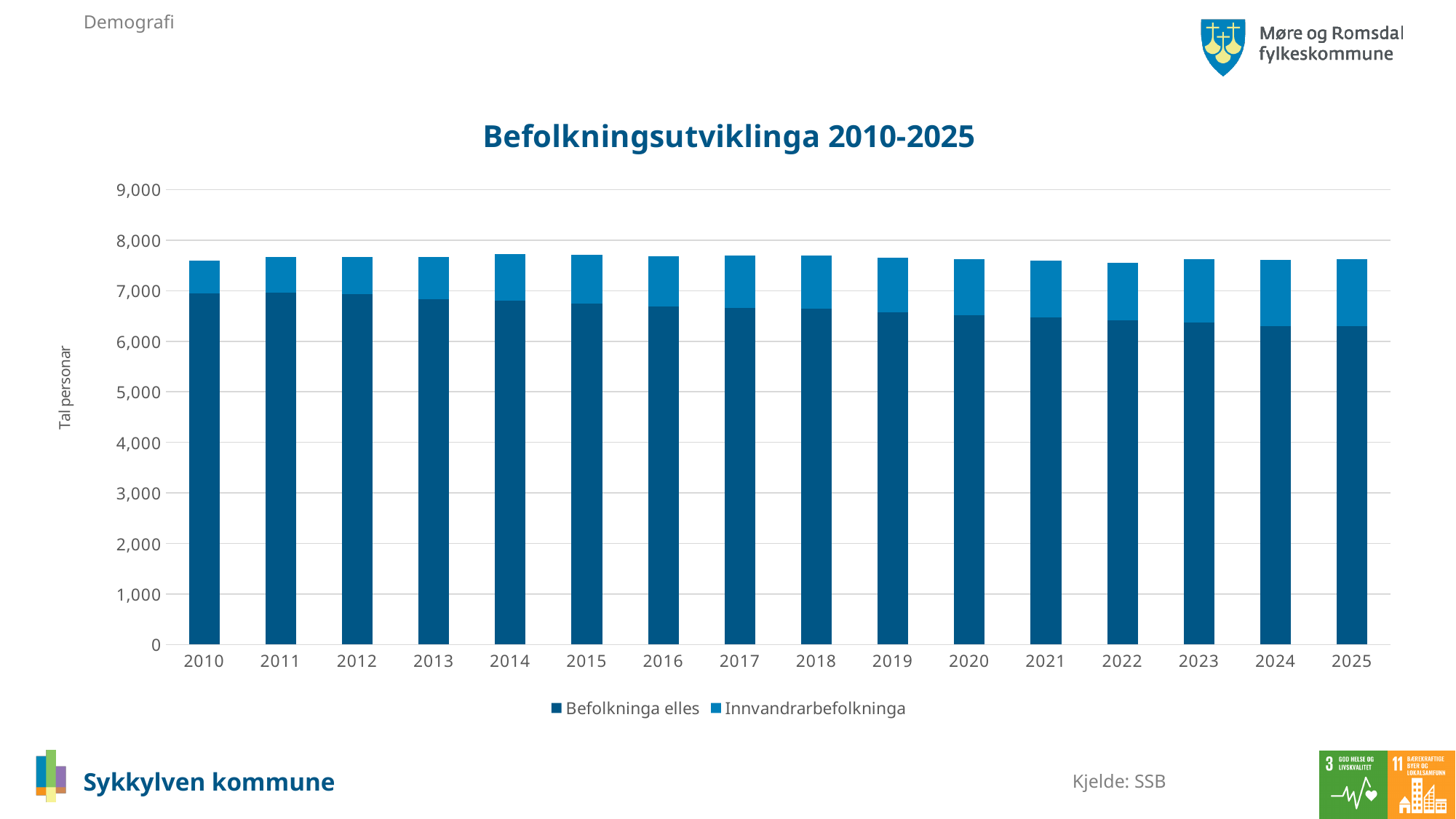
Does the value for Innvandrarbefolkninga rise or fall from 2010 to 2025? Rise Does the value for Befolkninga elles rise or fall from 2010 to 2025? Fall What is the title of the chart? Befolkningsutviklinga 2010-2025 Is the value for Befolkninga elles in 2010 greater or less than 6,000? greater What is the label on the vertical axis? Tal personar Which is larger, Innvandrarbefolkninga in 2010 or Innvandrarbefolkninga in 2025? 2025 Which is larger, Befolkninga elles in 2010 or Befolkninga elles in 2025? 2010 What kind of chart is shown on the slide? Stacked bar chart How many years are shown along the x axis? 16 Is the value for Befolkninga elles in 2025 greater or less than 7,000? less How many series does the legend list? 2 Is the total height of the stacked bar for 2025 greater or less than 7,000? greater